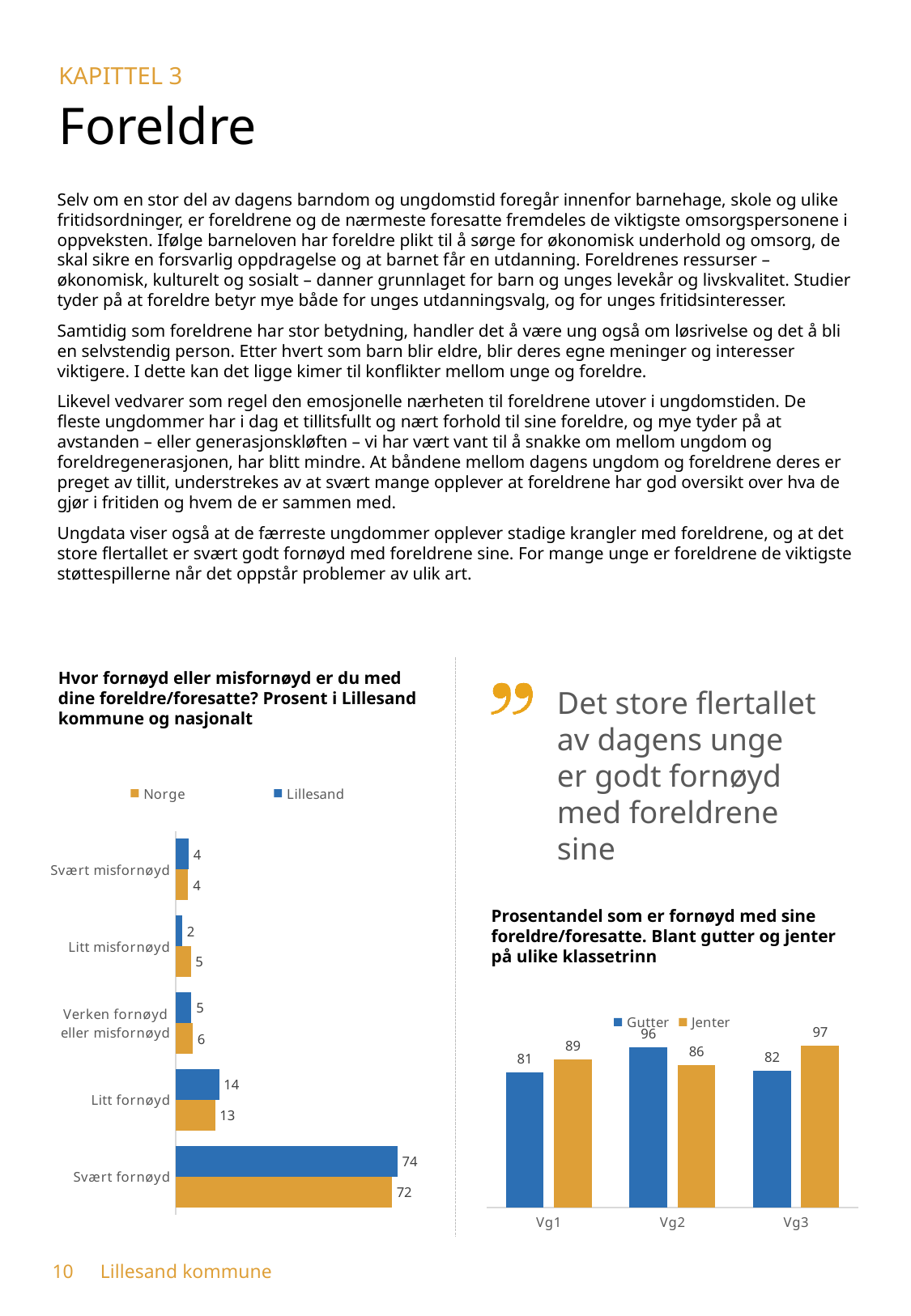
In the right chart (Prosentandel som er fornøyd med sine foreldre/foresatte), what is the value for Jenter at Vg3? 97 In the left chart (Hvor fornøyd eller misfornøyd er du med dine foreldre/foresatte?), what type of chart is used? Bar chart In the left chart (Hvor fornøyd eller misfornøyd er du med dine foreldre/foresatte?), what is the difference between Lillesand and Norge in the Svært fornøyd category? 2 In the left chart (Hvor fornøyd eller misfornøyd er du med dine foreldre/foresatte?), what is the value for Lillesand in the Svært fornøyd category? 74 In the left chart (Hvor fornøyd eller misfornøyd er du med dine foreldre/foresatte?), how many categories are shown? 5 In the left chart (Hvor fornøyd eller misfornøyd er du med dine foreldre/foresatte?), which category has the lowest value for Lillesand? Litt misfornøyd In the left chart (Hvor fornøyd eller misfornøyd er du med dine foreldre/foresatte?), which category has the highest value for Lillesand? Svært fornøyd In the right chart (Prosentandel som er fornøyd med sine foreldre/foresatte), what is the value for Gutter at Vg2? 96 In the right chart (Prosentandel som er fornøyd med sine foreldre/foresatte), how many series does the legend list? 2 In the right chart (Prosentandel som er fornøyd med sine foreldre/foresatte), which is larger at Vg1, Gutter or Jenter? Jenter In the left chart (Hvor fornøyd eller misfornøyd er du med dine foreldre/foresatte?), what is the value for Norge in the Litt misfornøyd category? 5 In the right chart (Prosentandel som er fornøyd med sine foreldre/foresatte), what is the difference between Jenter and Gutter at Vg3? 15